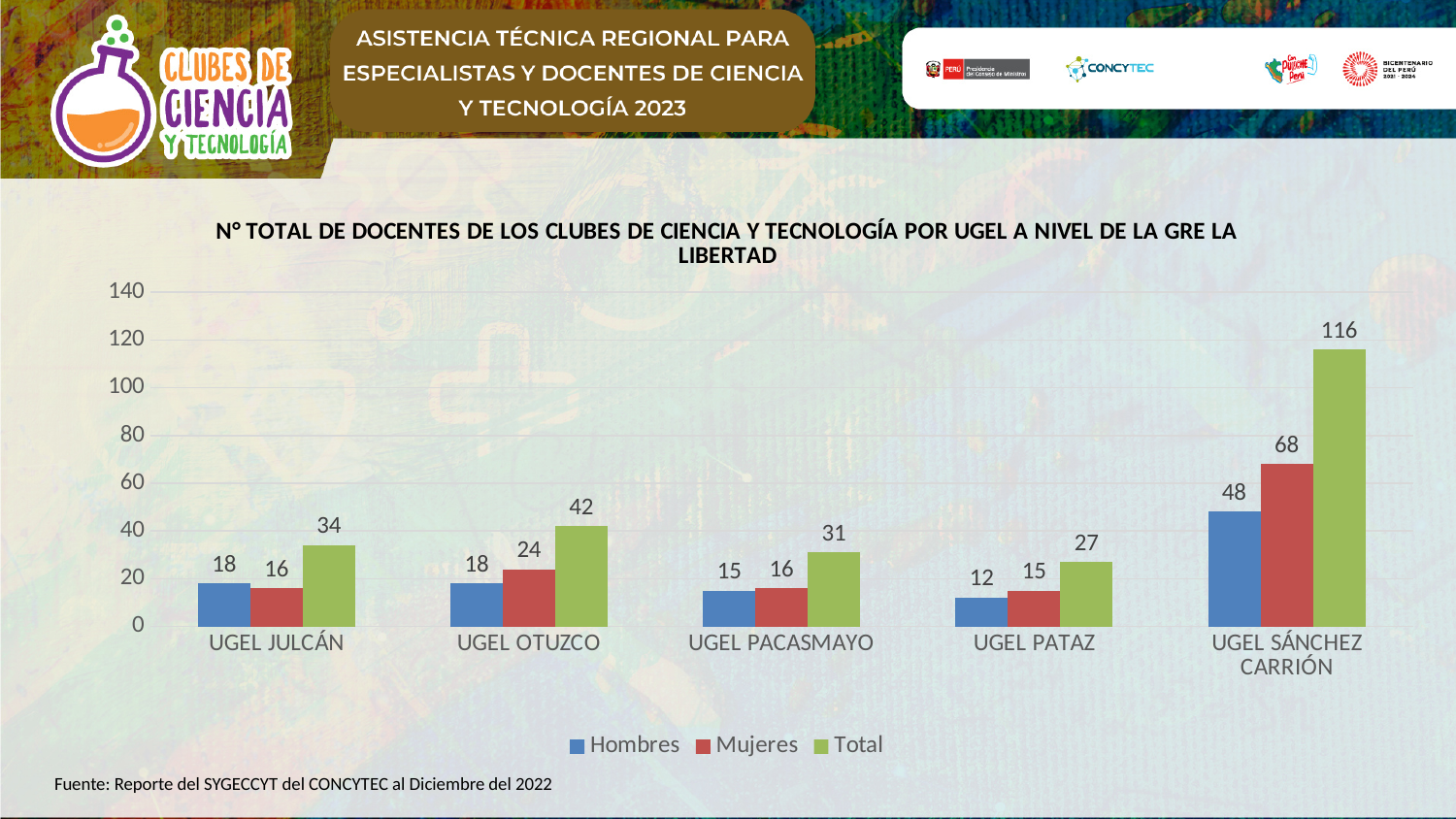
What is the difference between the Mujeres and Hombres values for UGEL Sánchez Carrión? 20 Which UGEL has the lowest Total value? UGEL Pataz How many UGEL categories are shown on the x axis? 5 What kind of chart is shown on the slide? Bar chart Which colour represents the Total series in the legend? Green What is the Mujeres value for UGEL Otuzco? 24 What is the Hombres value for UGEL Pataz? 12 Which is larger for UGEL Julcán, the Hombres value or the Mujeres value? Hombres Which UGEL has the highest Total value? UGEL Sánchez Carrión How many series does the legend list? 3 Is the Total value for UGEL Sánchez Carrión greater or less than 100? greater What is the Total value for UGEL Sánchez Carrión? 116